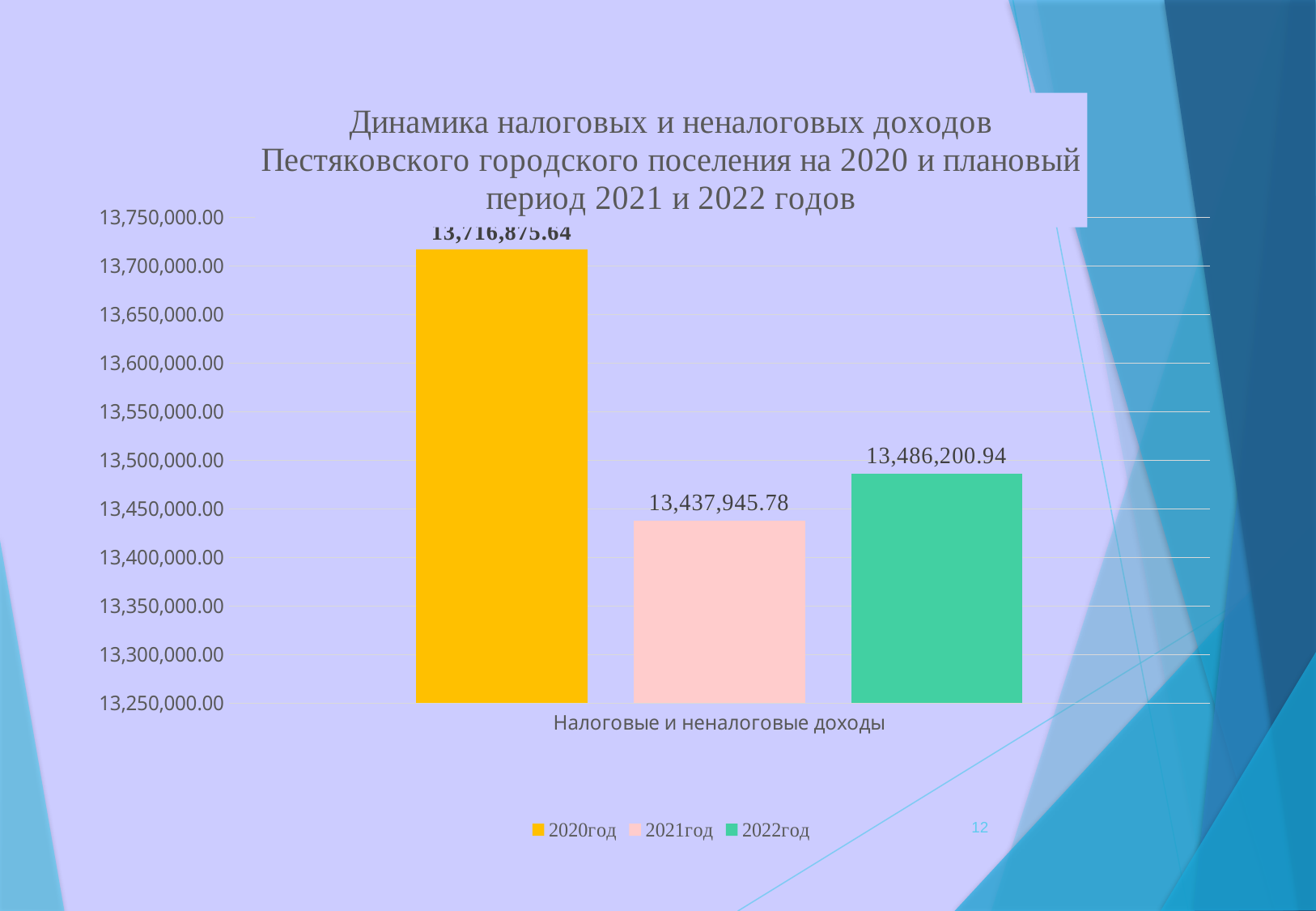
What is the difference between the 2020год and 2021год values? 278,929.86 What is the value for the 2022год series? 13,486,200.94 Which series has the highest value? 2020год What is the difference between the 2022год and 2021год values? 48,255.16 Which is larger, the value for 2021год or for 2022год? 2022год Which series has the lowest value? 2021год What kind of chart is shown on the slide? bar chart What is the value for the 2020год series? 13,716,875.64 Is the value for 2021год greater or less than 13,450,000.00? less What is the category label on the x axis? Налоговые и неналоговые доходы How many series does the legend list? 3 What is the value for the 2021год series? 13,437,945.78